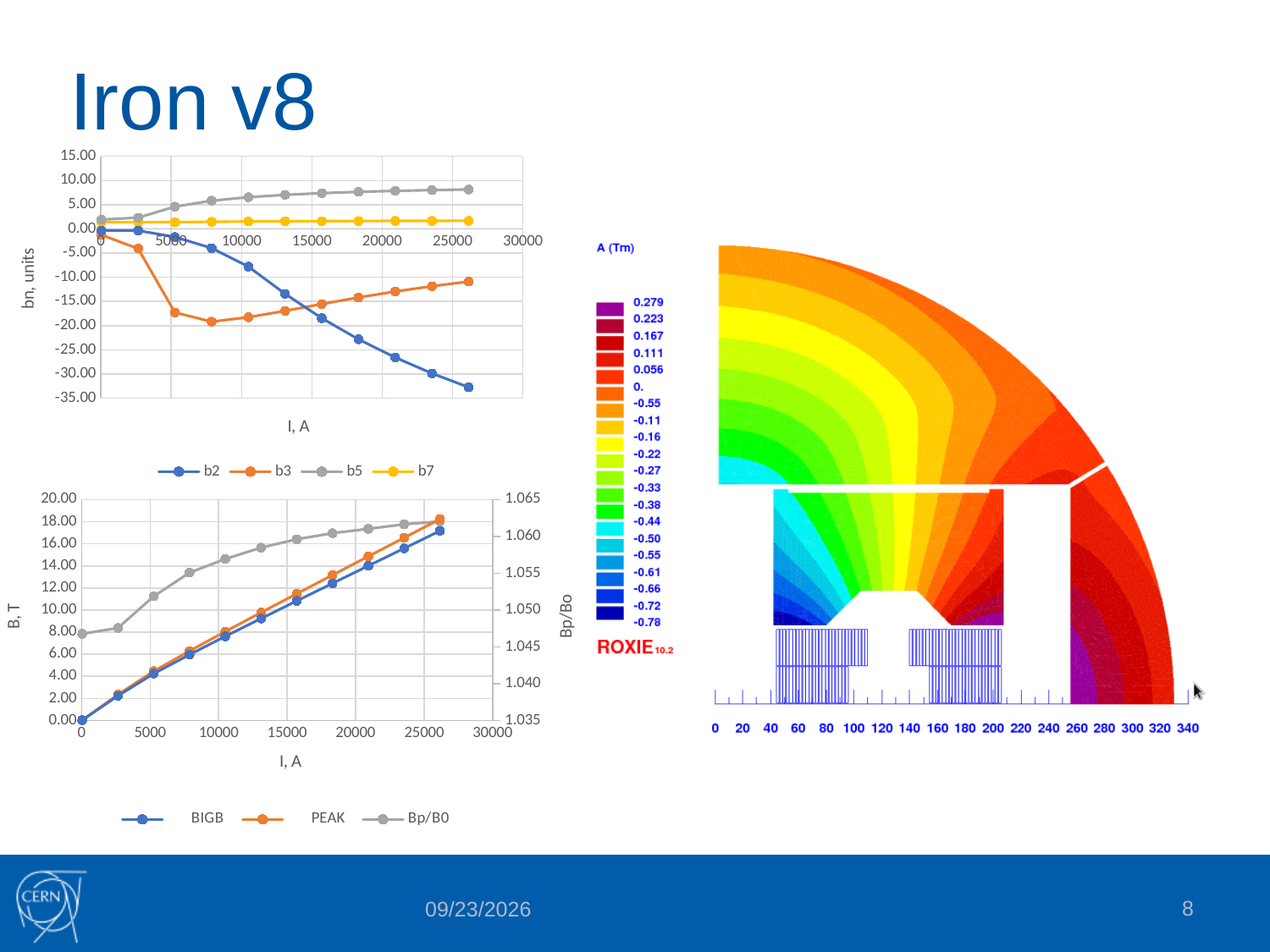
In the bottom-left chart, is the BIGB value at the highest current plotted greater or less than 15.00? greater In the top-left chart, is the value of b2 at the highest current plotted greater or less than -30.00? less In the top-left chart, is the lowest value of the b3 series greater or less than -15.00? less In the top-left chart, does the b2 series rise or fall as the current I increases? fall How many series does the legend of the top-left chart list? 4 What kind of chart is the top-left chart with series b2, b3, b5 and b7? line chart In the top-left chart, which series has the highest value at the highest current plotted? b5 What is the title of the vertical axis of the top-left chart? bn, units In the top-left chart, does the b5 series rise or fall as the current I increases? rise In the top-left chart, which series has the lowest value at the highest current plotted? b2 In the bottom-left chart, does the Bp/B0 series rise or fall as the current I increases? rise How many series does the legend of the bottom-left chart list? 3